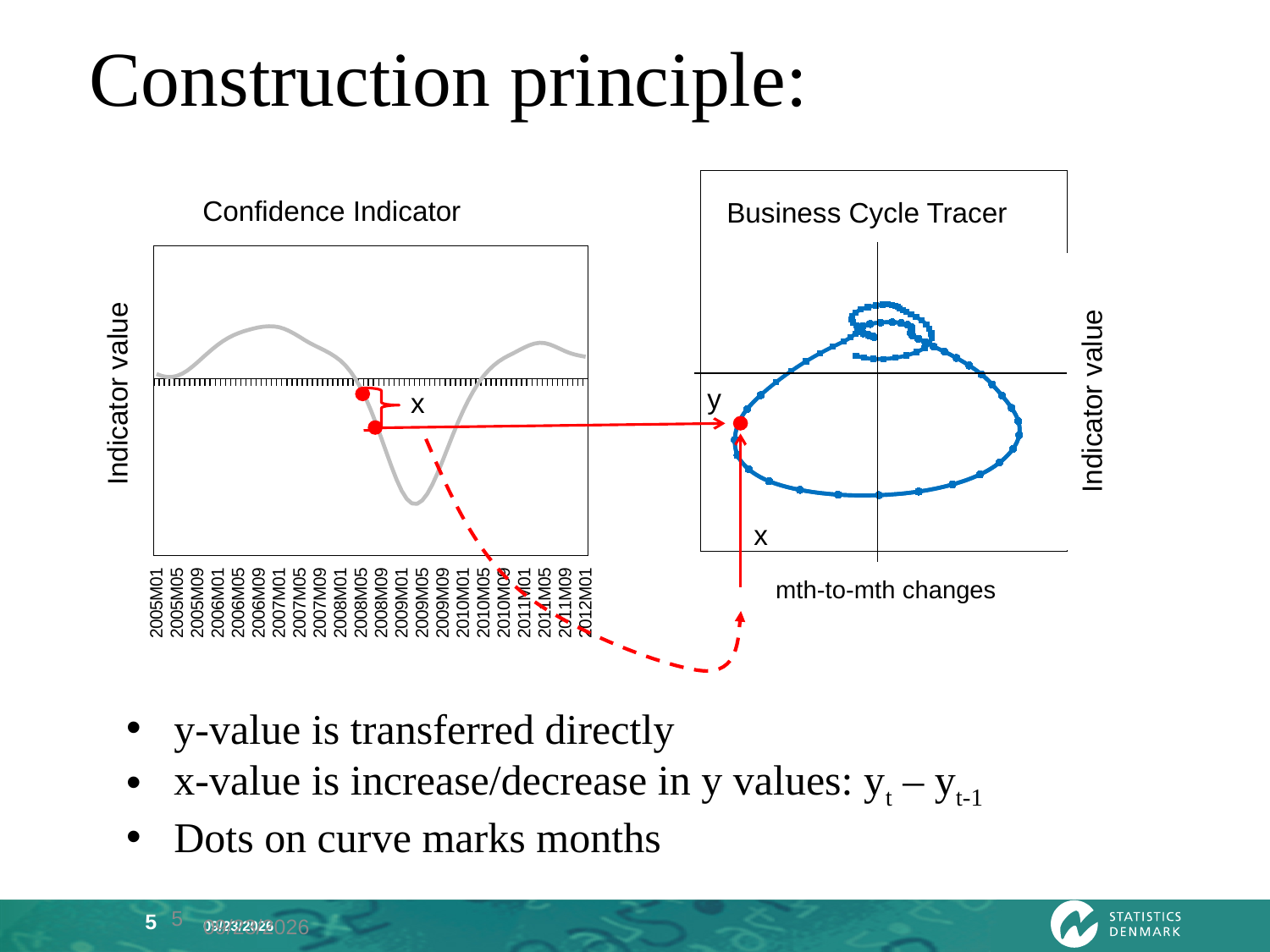
In the Confidence Indicator chart, does the line rise or fall between 2008M05 and 2009M01? fall What is the title of the chart on the right side of the slide? Business Cycle Tracer What is the title of the chart on the left side of the slide? Confidence Indicator What is the first x-axis label shown on the Confidence Indicator chart? 2005M01 In the Confidence Indicator chart, is the value at 2009M01 higher or lower than the value at 2007M01? lower What is the last x-axis label shown on the Confidence Indicator chart? 2012M01 How many x-axis labels are printed on the Confidence Indicator chart? 22 What kind of chart is the Confidence Indicator chart on the left? line chart In the Confidence Indicator chart, is the value at 2010M09 higher or lower than the value at 2009M05? higher What is the horizontal axis label of the Business Cycle Tracer chart? mth-to-mth changes In the Confidence Indicator chart, does the line rise or fall between 2009M05 and 2010M09? rise In the Confidence Indicator chart, does the line rise or fall between 2005M01 and 2006M09? rise